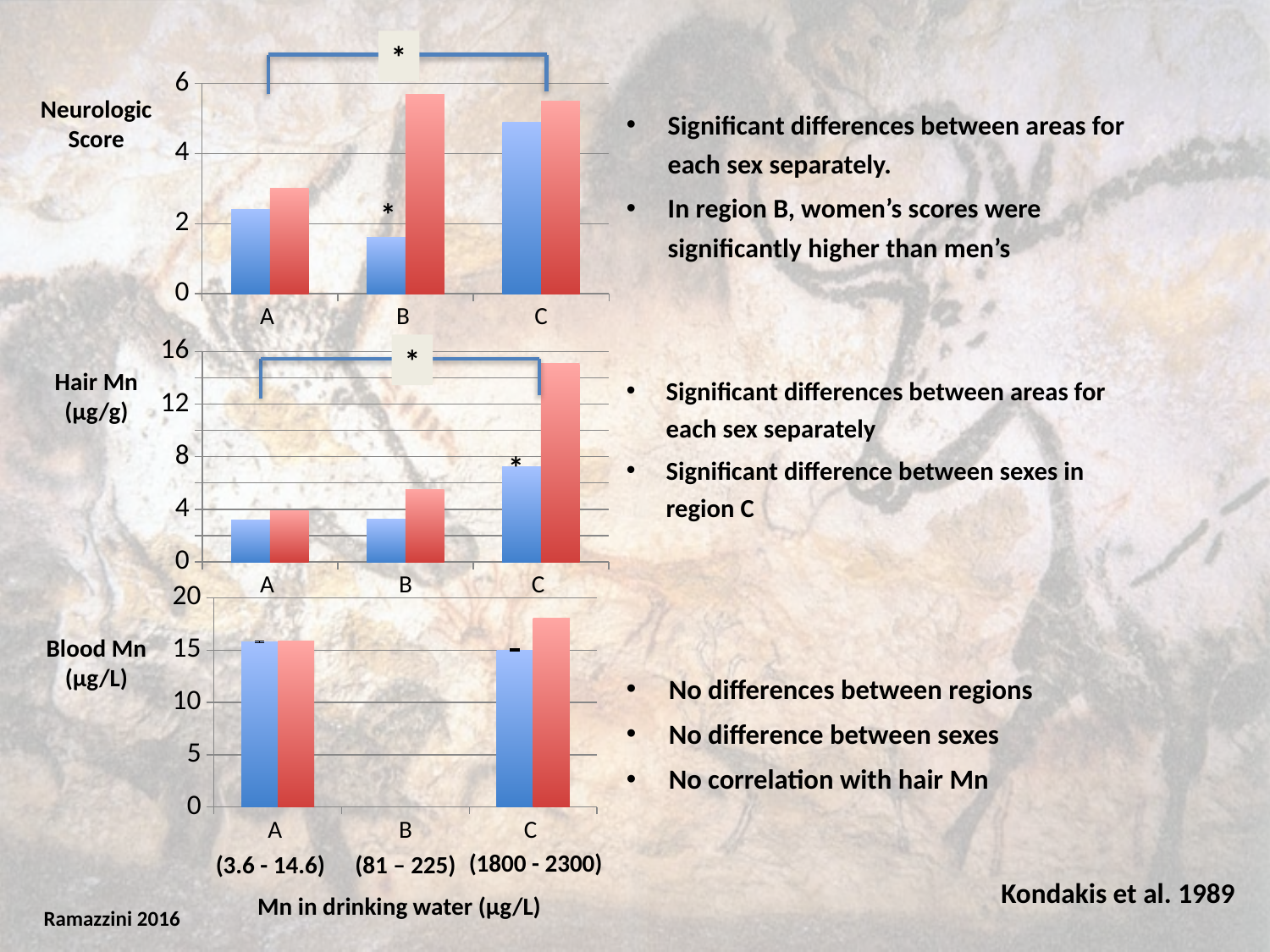
In the Hair Mn (µg/g) chart, which is taller for category B, the blue bar or the red bar? the red bar In the Blood Mn (µg/L) chart, is the red bar for C greater or less than 15? greater In the Neurologic Score chart, which category has the shortest blue bar? B In the Neurologic Score chart, is the blue bar for B greater or less than 2? less In the Neurologic Score chart, which category has the tallest blue bar? C How many categories are shown on the x axis of the Blood Mn (µg/L) chart? 3 What kind of chart is the Neurologic Score chart? bar chart In the Hair Mn (µg/g) chart, is the red bar for C greater or less than 12? greater In the Hair Mn (µg/g) chart, which category has the tallest red bar? C What is the x-axis title shown below the Blood Mn (µg/L) chart? Mn in drinking water (µg/L)